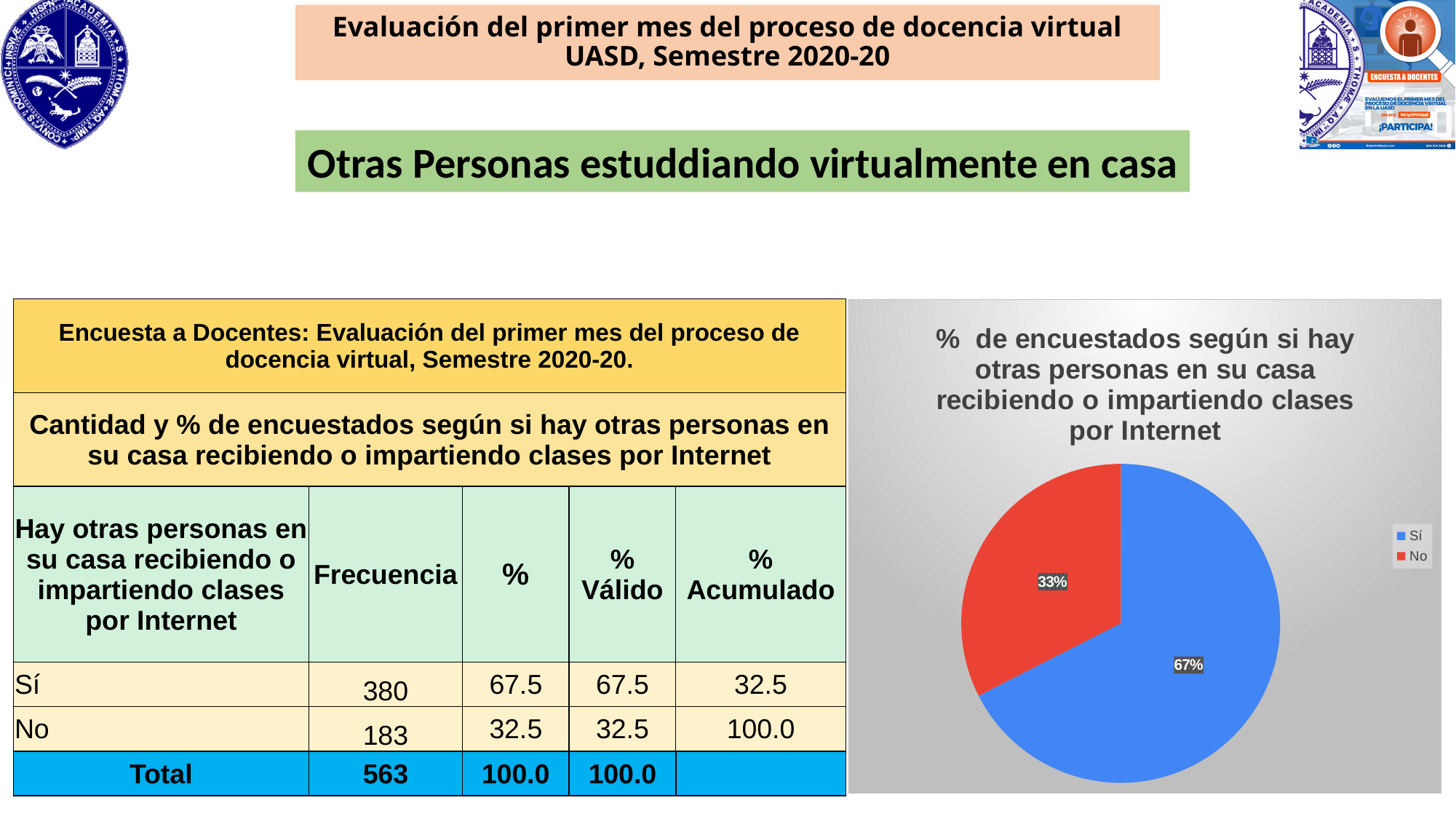
What is the title of the pie chart? % de encuestados según si hay otras personas en su casa recibiendo o impartiendo clases por Internet How many slices does the pie chart have? 2 What kind of chart is shown on the slide? pie chart Which slice of the pie chart is the smallest? No What percentage does the pie chart show for "No"? 33% What is the difference in percentage points between the "Sí" and "No" slices of the pie chart? 34% What percentage does the pie chart show for "Sí"? 67% How many entries does the pie chart's legend list? 2 Which slice of the pie chart is the largest? Sí In the pie chart, which is larger, the share for "Sí" or the share for "No"? Sí What colour is the "No" slice in the pie chart? red